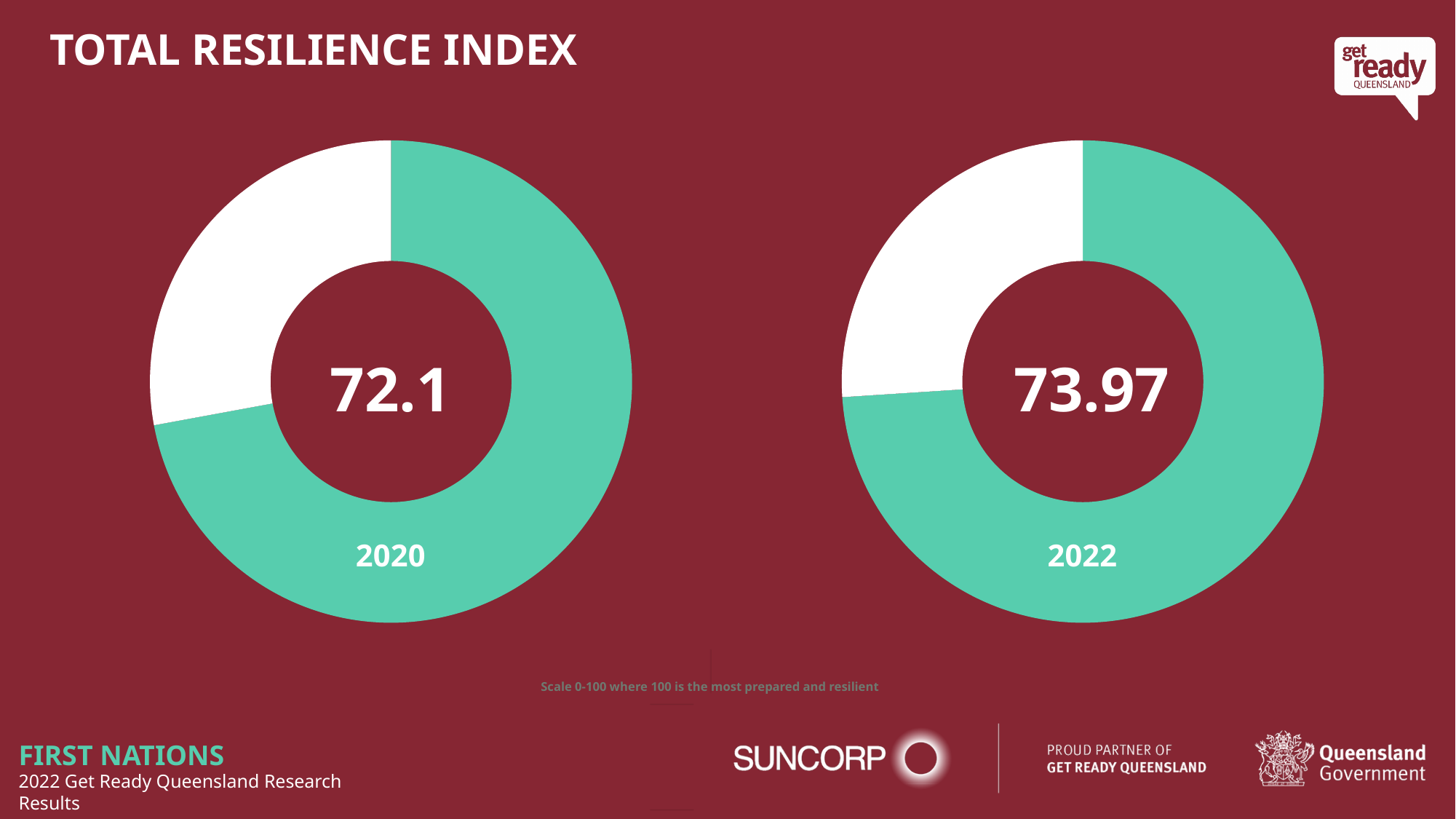
Which year has the higher Total Resilience Index, 2020 or 2022? 2022 Did the Total Resilience Index rise or fall from 2020 to 2022? rise Which year shows the highest Total Resilience Index on the slide? 2022 By how much did the Total Resilience Index increase from 2020 to 2022? 1.87 How many donut charts are shown on the slide? 2 What kind of chart is used to display the Total Resilience Index values? donut chart Which year shows the lowest Total Resilience Index on the slide? 2020 What is the title of the slide containing the two donut charts? TOTAL RESILIENCE INDEX According to the note below the charts, what scale is the Total Resilience Index measured on? 0-100 What is the Total Resilience Index value shown in the 2020 donut chart? 72.1 Is the 2020 Total Resilience Index value greater or less than 70? greater What is the Total Resilience Index value shown in the 2022 donut chart? 73.97